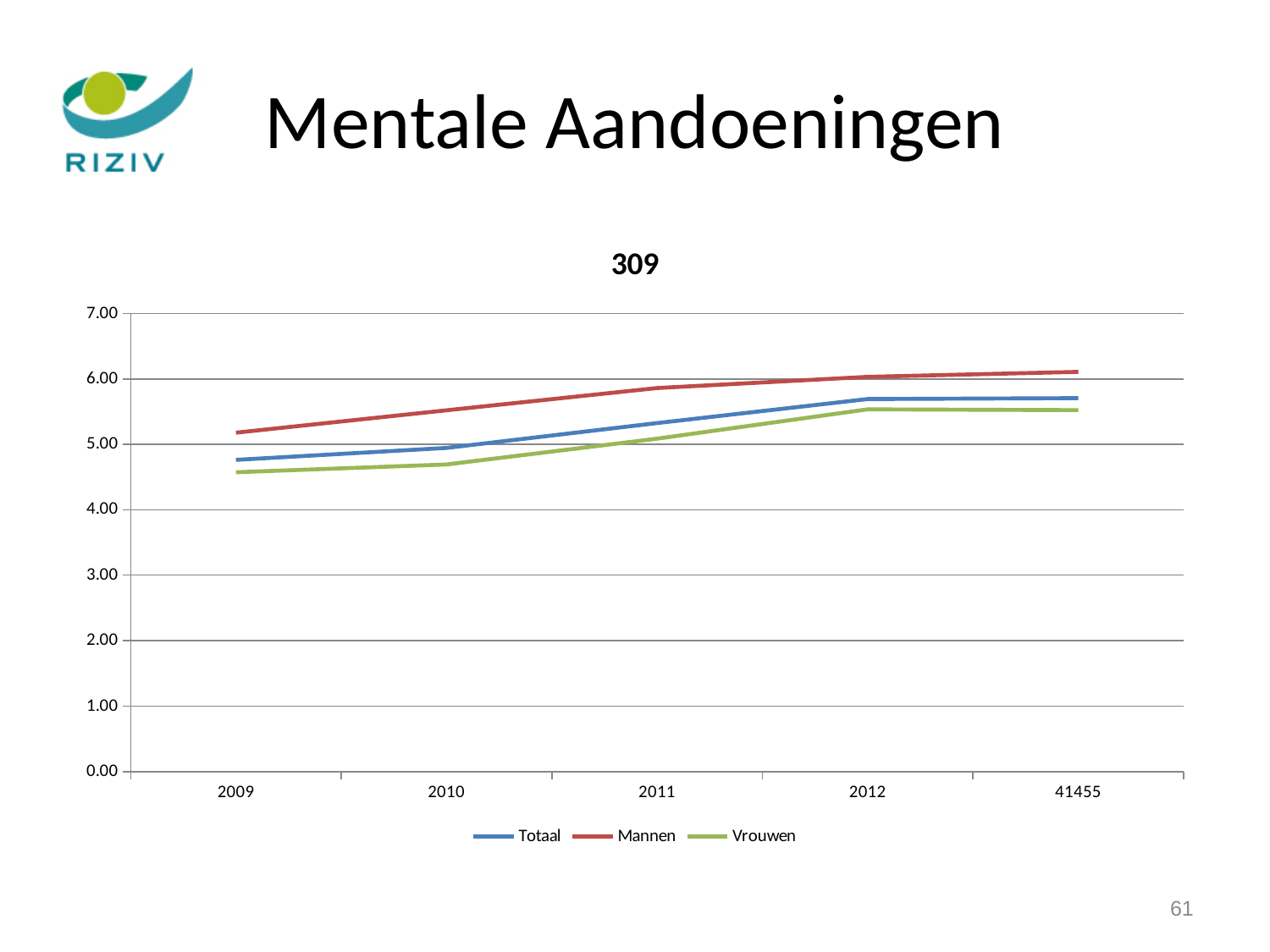
Which is larger in 2012, the value for Mannen or the value for Vrouwen? Mannen How many points are plotted along the x axis for each series? 5 Does the Mannen series rise or fall from 2009 to 2012? rise What is the title of the chart? 309 Which series is drawn in red? Mannen Is the value for Mannen in 2009 greater or less than 5.00? greater Which series has the lowest value in 2011? Vrouwen Is the value for Totaal in 2012 greater or less than 6.00? less How many series does the legend list? 3 Which series has the highest value in 2009? Mannen Is the value for Vrouwen in 2009 greater or less than 5.00? less What kind of chart is shown on the slide? line chart